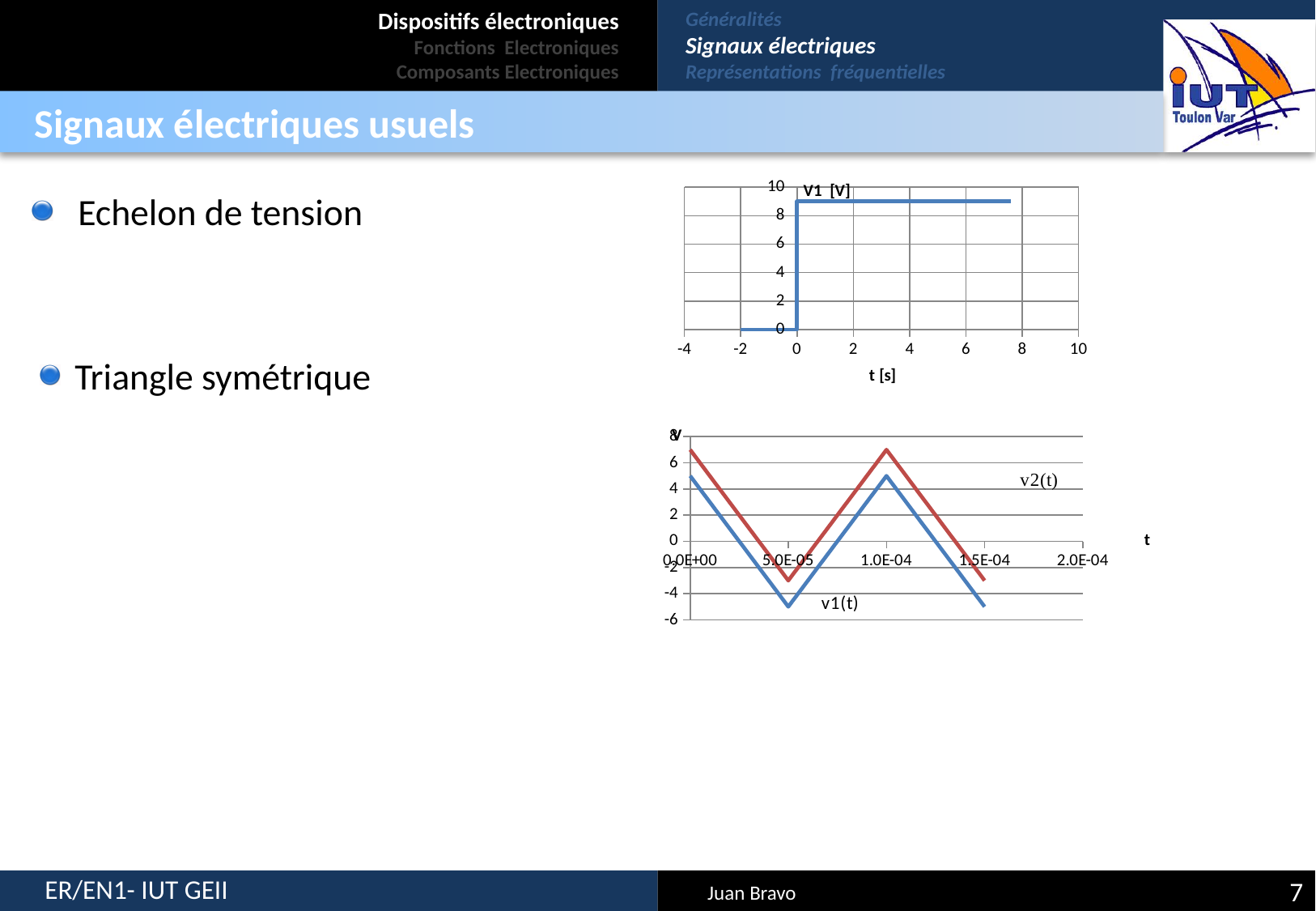
On the bottom chart (triangle signals), what kind of chart is it? line chart On the bottom chart (triangle signals), is the value of v1(t) at t = 5.0E-05 greater or less than -4? less On the bottom chart (triangle signals), which series is larger at t = 1.0E-04, v1(t) or v2(t)? v2(t) On the top chart (V1 [V]), is the value of V1 at t = 4 s greater or less than 8? greater On the bottom chart (triangle signals), how many series are plotted? 2 On the top chart (V1 [V]), what kind of chart is it? line chart On the top chart (V1 [V]), what is the label of the horizontal axis? t [s] On the bottom chart (triangle signals), is the value of v2(t) at t = 5.0E-05 greater or less than -4? greater On the bottom chart (triangle signals), does v1(t) rise or fall between t = 0.0E+00 and t = 5.0E-05? fall On the top chart (V1 [V]), what is the value of V1 at t = -2 s? 0